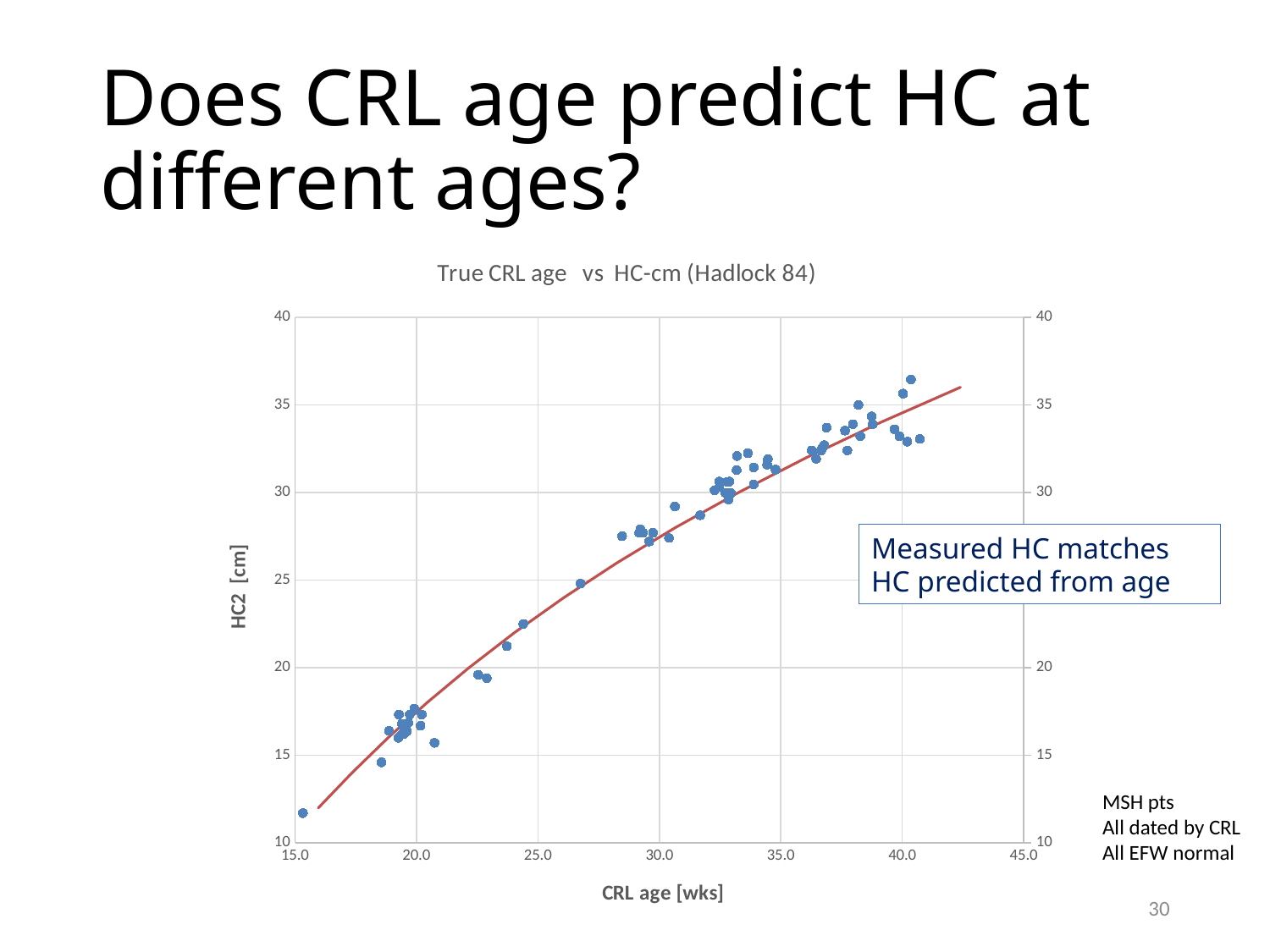
What is the title of the chart? True CRL age vs HC-cm (Hadlock 84) What is the label of the x axis? CRL age [wks] Are the HC2 values for the points at a CRL age of about 30 weeks greater or less than 25? greater What kind of chart is shown on the slide? scatter plot Are the HC2 values for the points at a CRL age of about 40 weeks greater or less than 30? greater Is the HC2 value for the point at a CRL age of about 27 weeks greater or less than 20? greater Do the HC2 values rise or fall as CRL age increases along the x axis? rise